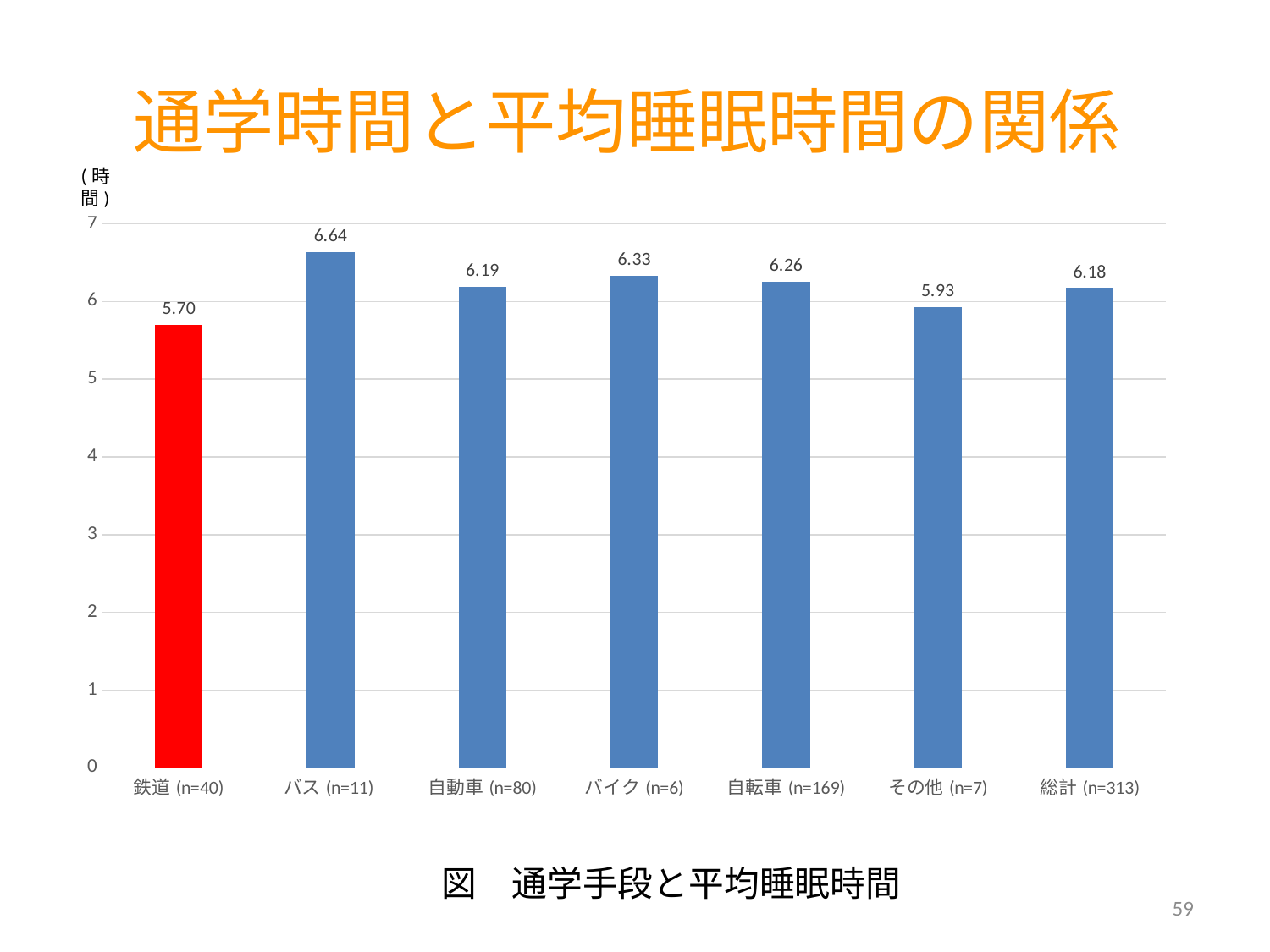
Which category has the lowest value? 鉄道 (n=40) Which category has the highest value? バス (n=11) Which bar is coloured red? 鉄道 (n=40) What is the value for 鉄道 (n=40)? 5.70 What is the value for 総計 (n=313)? 6.18 How many categories are shown on the x axis? 7 What is the difference between the values for バス (n=11) and 鉄道 (n=40)? 0.94 Is the value for その他 (n=7) greater or less than 6? less What is the value for バス (n=11)? 6.64 Which is larger, the value for バイク (n=6) or the value for 自転車 (n=169)? バイク (n=6) What kind of chart is this? bar chart What is the title of the slide? 通学時間と平均睡眠時間の関係